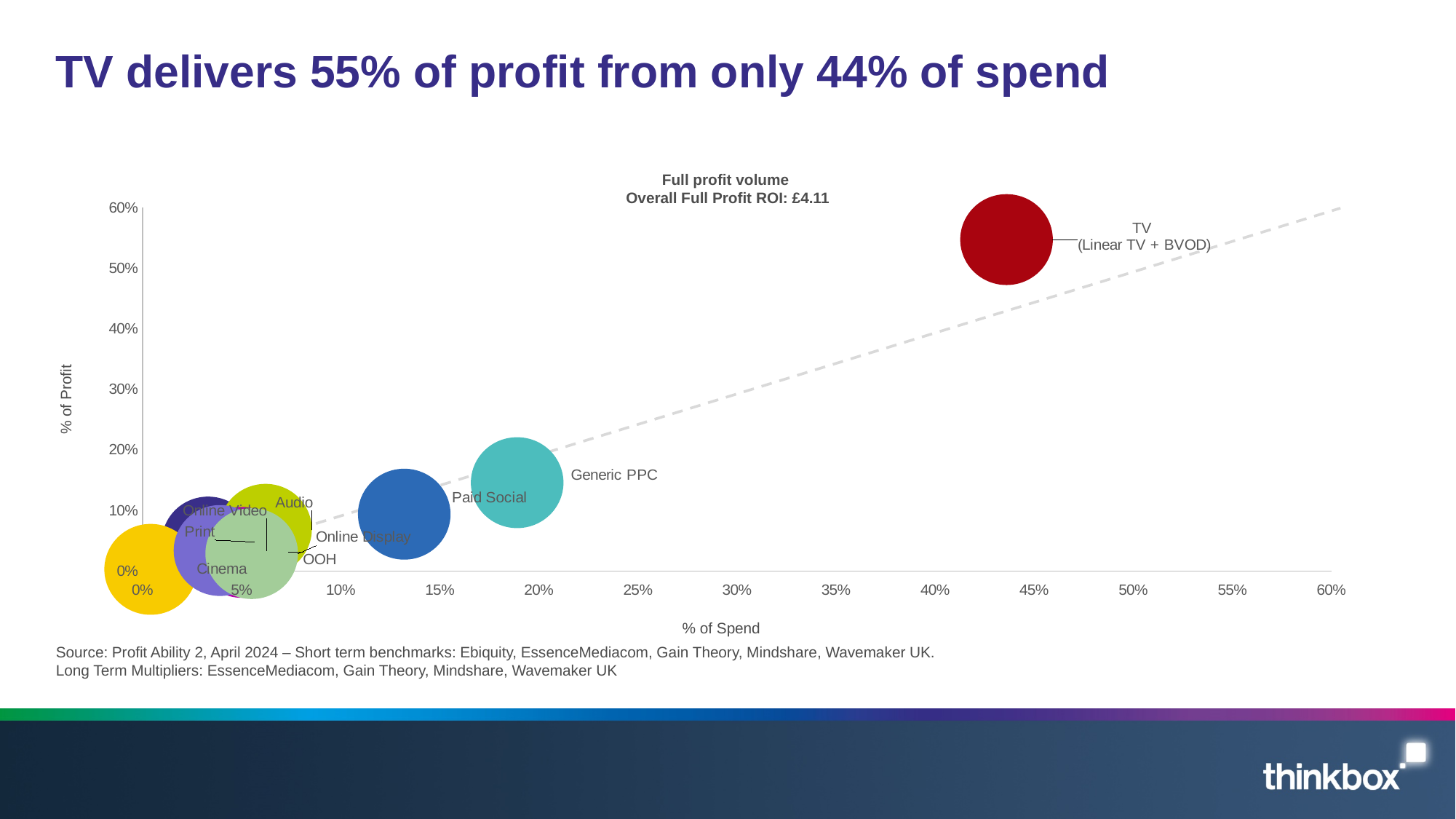
Which has a higher % of profit, Generic PPC or Paid Social? Generic PPC What is the Overall Full Profit ROI stated in the chart title? £4.11 Is the % of spend for Generic PPC greater or less than 25%? less What is the label of the x axis? % of Spend Is the % of profit for TV (Linear TV + BVOD) greater or less than 50%? greater Which has a higher % of spend, TV (Linear TV + BVOD) or Generic PPC? TV (Linear TV + BVOD) What kind of chart is shown on the slide? Bubble chart Which media channel has the highest % of profit? TV (Linear TV + BVOD) Is the % of profit for Paid Social greater or less than 20%? less According to the slide, what % of profit does TV deliver? 55% According to the slide, what % of spend does TV account for? 44% Do the bubbles generally rise or fall in % of profit as % of spend increases along the x axis? Rise